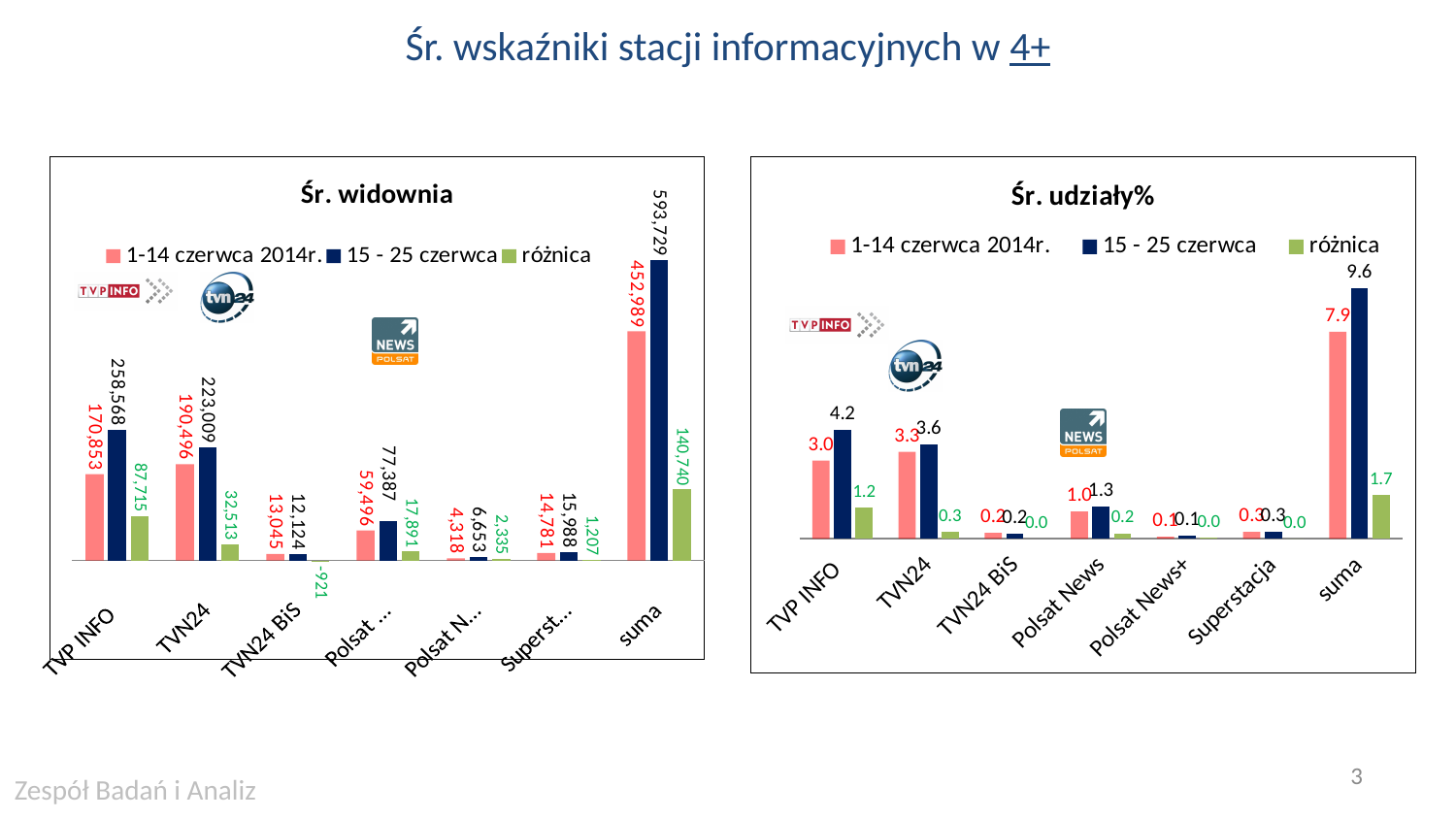
In the 'Śr. udziały%' chart, which station (excluding suma) has the highest '15 - 25 czerwca' value? TVP INFO In the 'Śr. widownia' chart, which category has a negative 'różnica' value? TVN24 BiS In the 'Śr. udziały%' chart, what is the '1-14 czerwca 2014r.' value for Polsat News? 1.0 What type of chart is the 'Śr. udziały%' chart? Bar chart In the 'Śr. widownia' chart, what is the value for TVP INFO in the '15 - 25 czerwca' series? 258,568 In the 'Śr. udziały%' chart, what is the 'różnica' value for TVP INFO? 1.2 In the 'Śr. widownia' chart, what is the 'różnica' value for TVN24? 32,513 In the 'Śr. widownia' chart, which is larger for TVN24 BiS: the '1-14 czerwca 2014r.' value or the '15 - 25 czerwca' value? 1-14 czerwca 2014r. In the 'Śr. widownia' chart, what is the difference between the '15 - 25 czerwca' and '1-14 czerwca 2014r.' values for suma? 140,740 In the 'Śr. widownia' chart, how many series does the legend list? 3 How many categories are shown on the x axis of the 'Śr. udziały%' chart? 7 In the 'Śr. udziały%' chart, what is the '15 - 25 czerwca' value for suma? 9.6